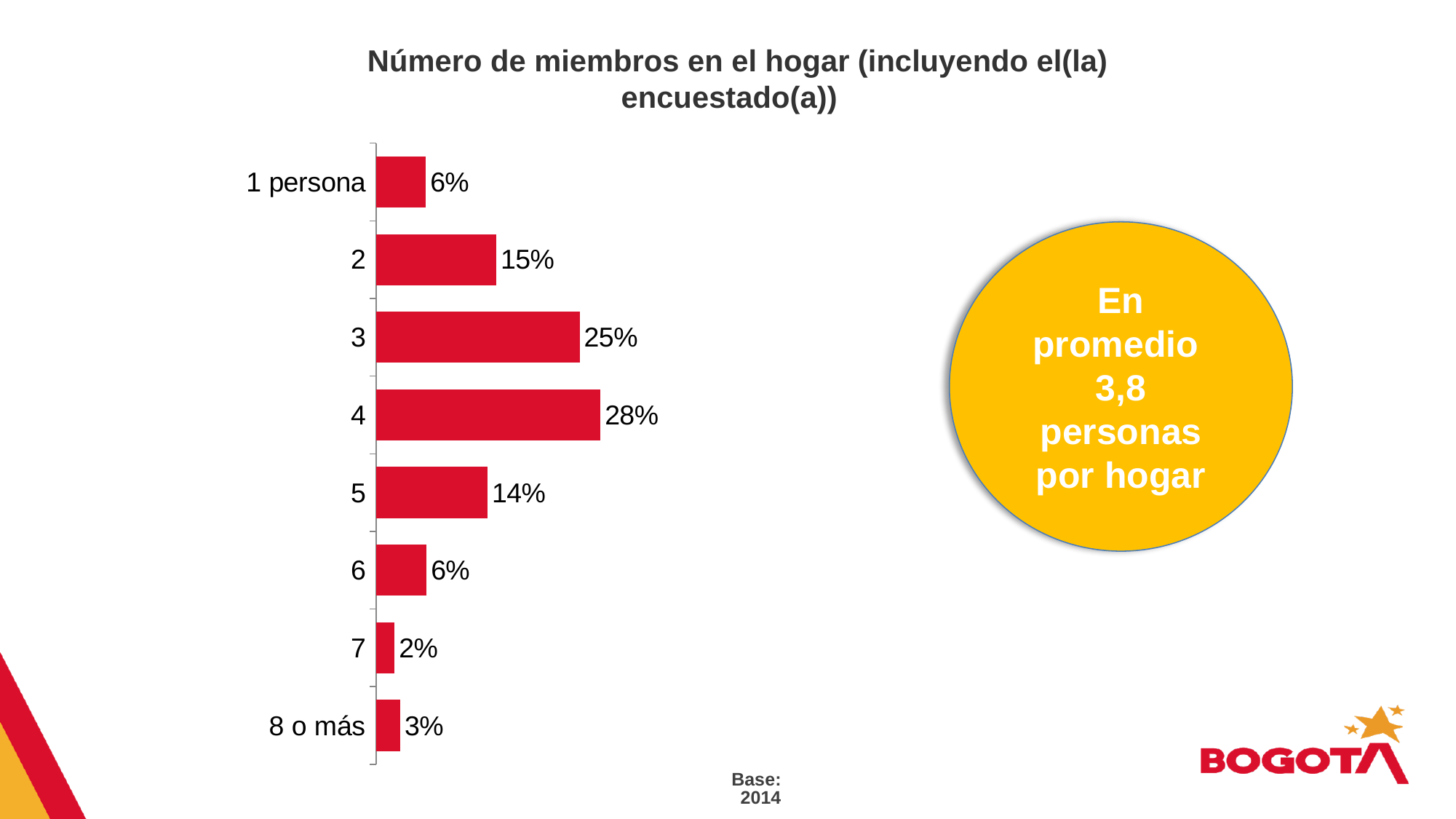
What is the title of the chart? Número de miembros en el hogar (incluyendo el(la) encuestado(a)) How many household size categories are shown in the chart? 8 Which household size category has the highest percentage? 4 What is the value shown for households with 2 members? 15% What percentage is shown for '8 o más' members? 3% What is the difference between the percentage for 5 members and the percentage for 6 members? 8% Which household size category has the lowest percentage? 7 What is the difference between the percentage for 4 members and the percentage for 3 members? 3% What average number of persons per household is stated in the yellow circle? 3,8 What percentage of households have 4 members? 28% Which is larger, the value for 2 members or the value for 5 members? 2 members What type of chart is shown on the slide? Bar chart